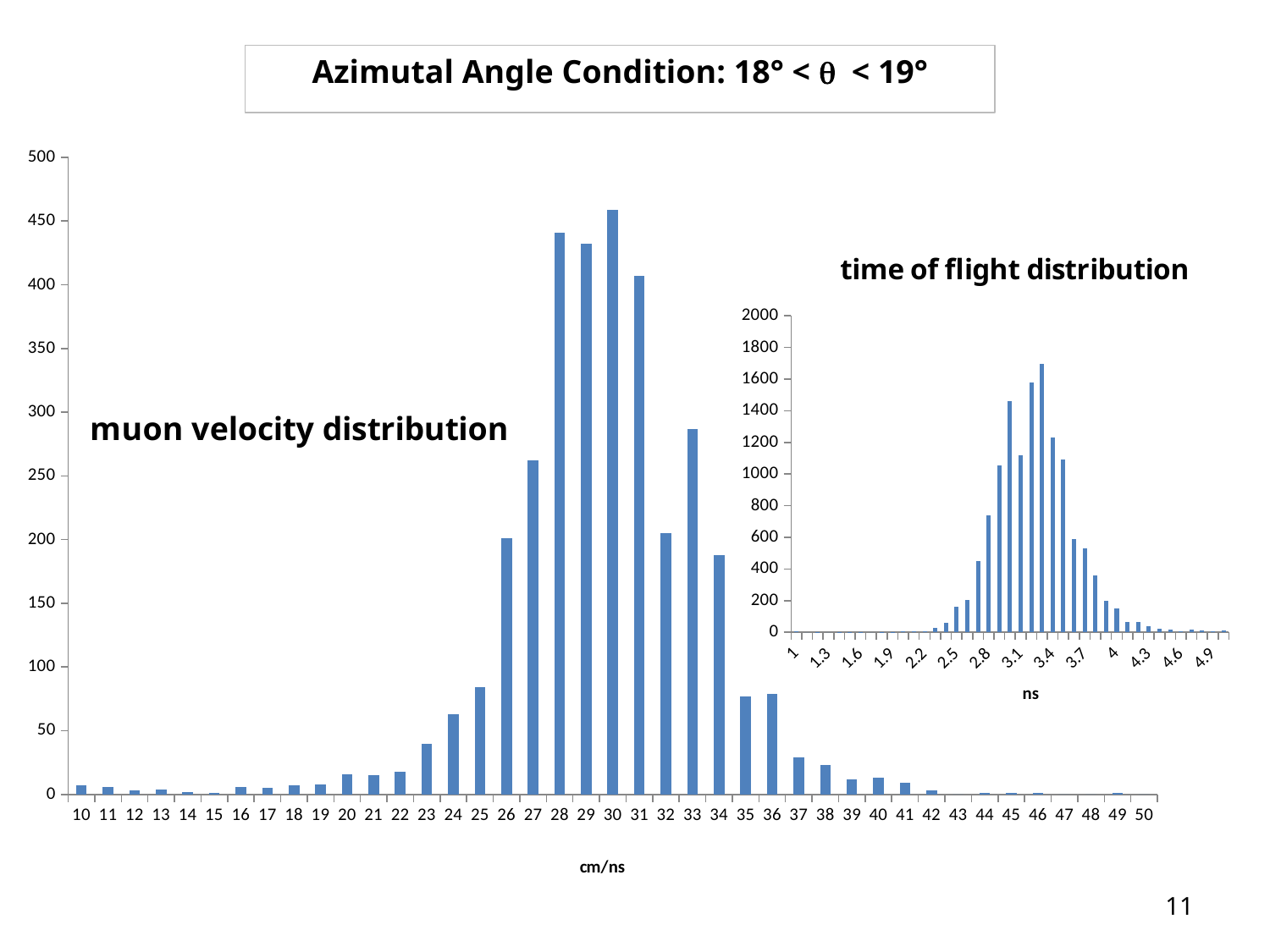
In the muon velocity distribution, which category has the highest bar? 30 In the time of flight distribution, is the value for 3.4 greater or less than 1600? less In the muon velocity distribution, is the value for 25 greater or less than 100? less What kind of chart is the muon velocity distribution? bar chart In the muon velocity distribution, is the value for 27 greater or less than 250? greater In the muon velocity distribution, do the values rise or fall along the x axis from 30 to 40? fall How many categories are shown on the x axis of the muon velocity distribution? 41 What unit is shown on the x axis of the muon velocity distribution? cm/ns In the muon velocity distribution, which is larger, the value for 28 or the value for 32? 28